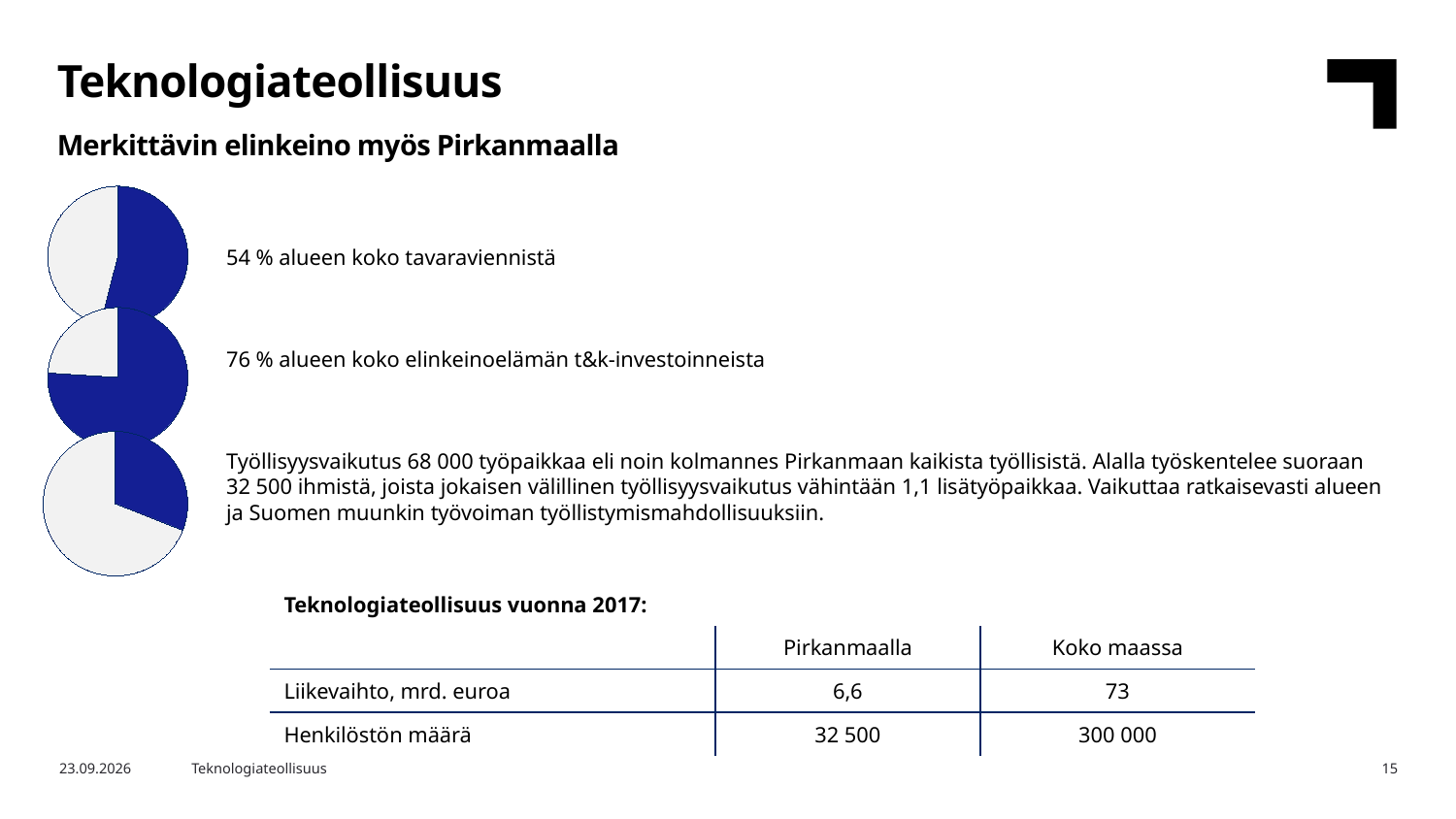
In the bottom pie chart, is the blue slice greater or less than 50% of the pie? less Which pie chart has the smallest blue slice? The bottom one In the middle pie chart, what share of the region's business R&D investments does the blue slice represent? 76 % Which pie chart has the larger blue slice, the top one or the middle one? The middle one In the top pie chart, is the blue slice greater or less than 50% of the pie? greater What kind of charts are shown on the left side of the slide? Pie charts What colour is used for the highlighted slice in the pie charts? Blue How many slices does each pie chart have? 2 In the top pie chart, what share of the region's total goods exports does the blue slice represent? 54 % How many pie charts are on the slide? 3 What is the difference between the blue shares of the middle and top pie charts? 22 percentage points